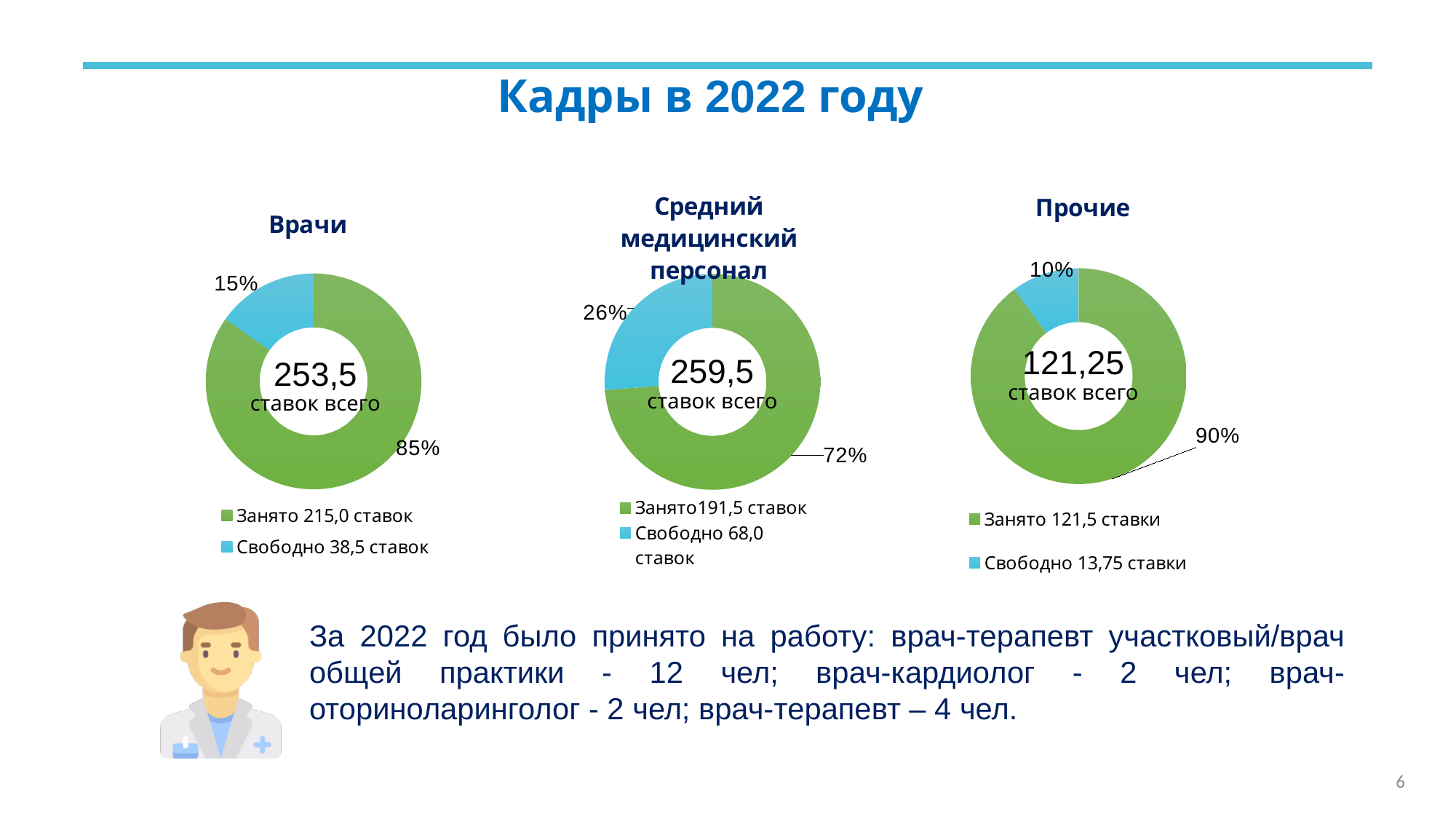
How many slices does the "Средний медицинский персонал" chart have? 2 What total number of positions is shown in the centre of the "Прочие" chart? 121,25 What kind of chart is used for "Врачи"? Doughnut (pie) chart According to the legend of the "Врачи" chart, how many positions are free (Свободно)? 38,5 ставок In the "Прочие" chart, which slice is larger: Занято or Свободно? Занято In the "Средний медицинский персонал" chart, what share is labelled as free (Свободно)? 26% In the "Прочие" chart, what share is labelled as occupied (Занято)? 90% What total number of positions is shown in the centre of the "Средний медицинский персонал" chart? 259,5 In the "Средний медицинский персонал" chart, what share is labelled as occupied (Занято)? 72% What total number of positions is shown in the centre of the "Врачи" chart? 253,5